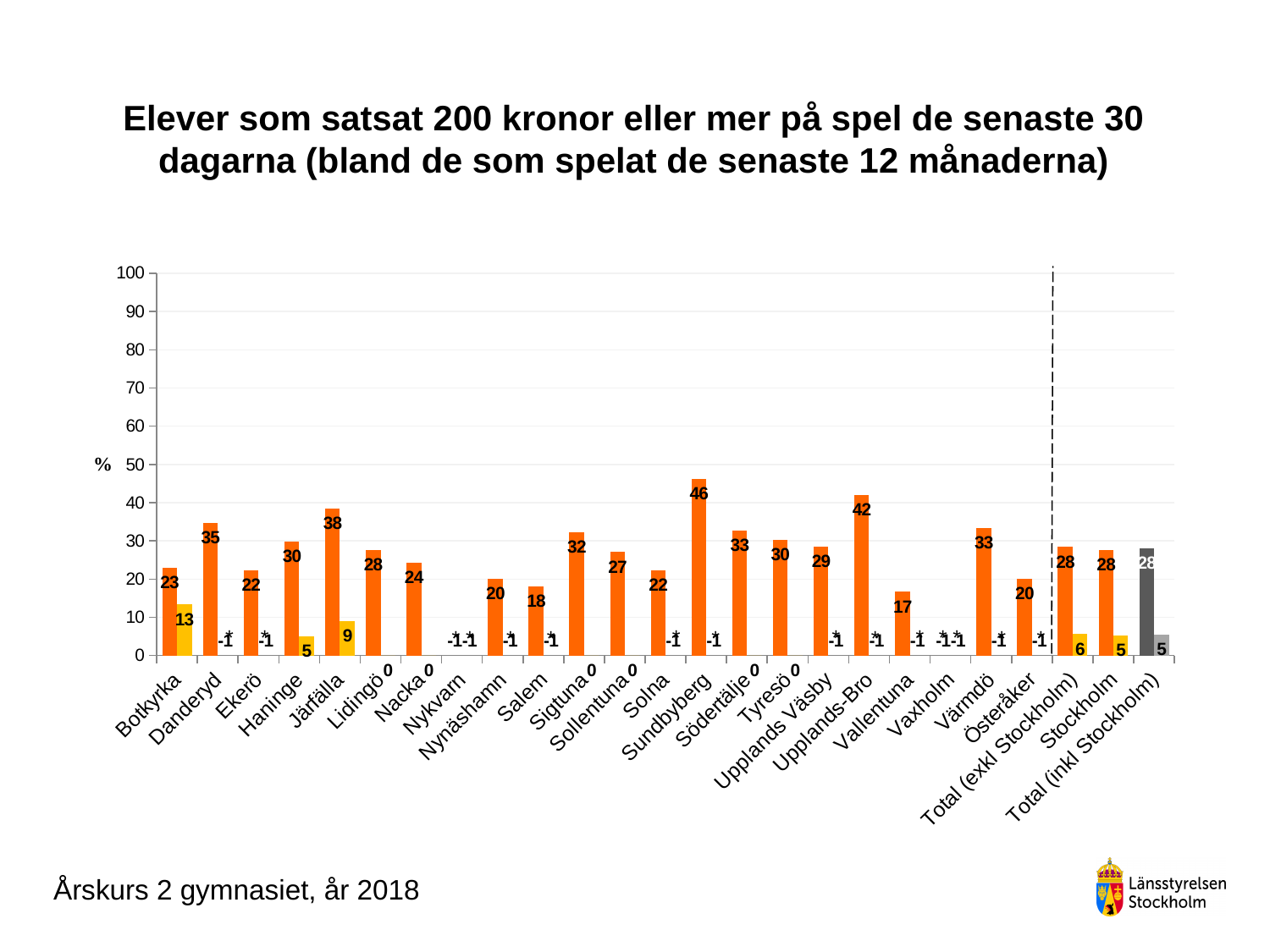
Is the orange bar value for Upplands-Bro greater or less than 40? greater What is the difference between the orange bar values for Sundbyberg and Vallentuna? 29 Which municipality has the highest orange bar? Sundbyberg What is the value of the yellow bar for Botkyrka? 13 What is the value of the yellow bar for Järfälla? 9 What type of chart is shown on the slide? Bar chart Among the municipalities with a plotted orange bar, which has the lowest value? Vallentuna What unit is shown on the vertical axis label? % What is the value of the orange bar for Sundbyberg? 46 What is the value of the orange bar for Upplands-Bro? 42 Which has a larger orange bar value, Danderyd or Järfälla? Järfälla